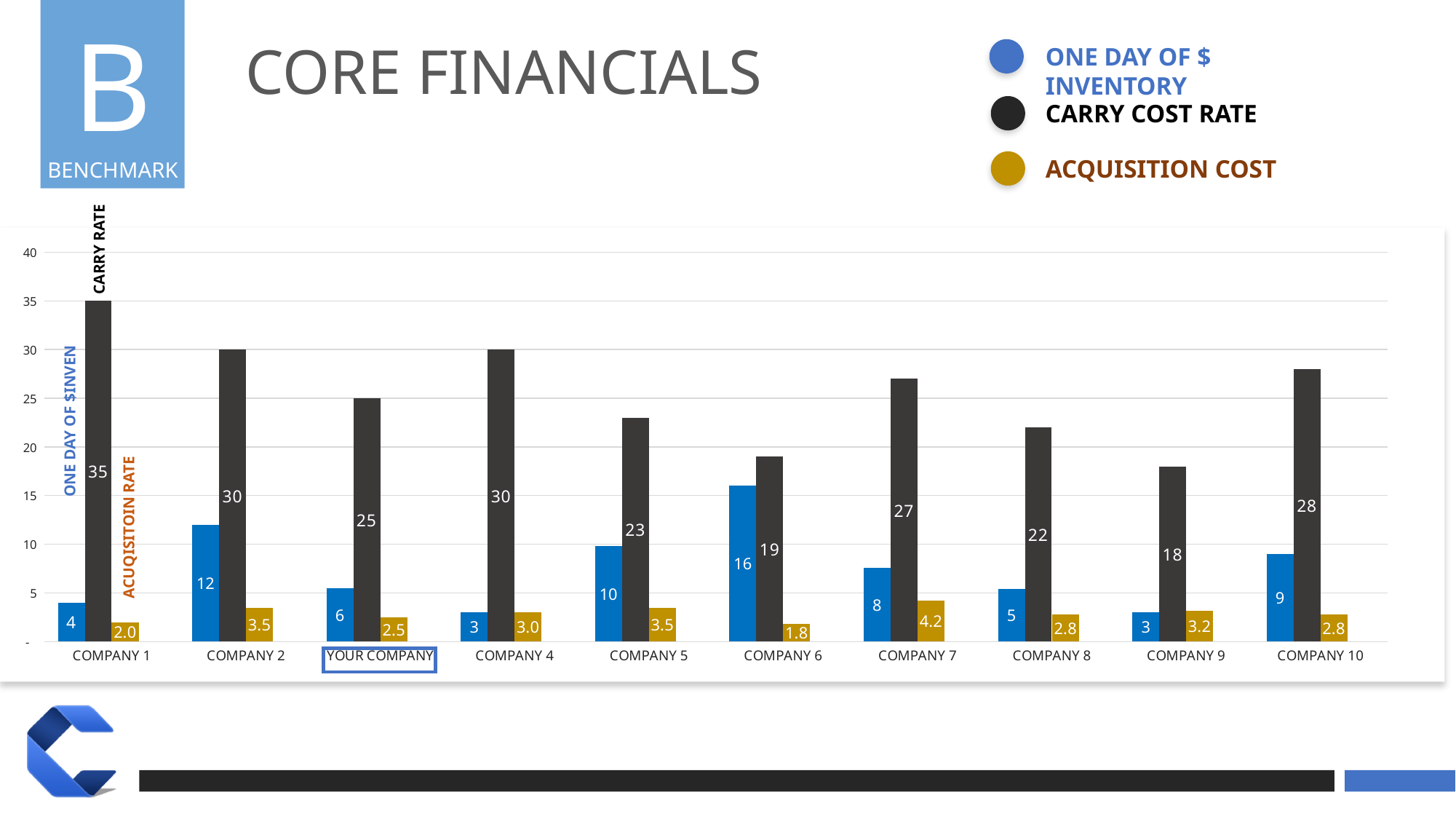
What is the difference between the Carry Cost Rate of Company 2 and Your Company? 5 How many series does the legend list? 3 What is the Carry Cost Rate value for Company 1? 35 Which company has the lowest Acquisition Cost? Company 6 Which is larger, the Carry Cost Rate for Company 7 or for Company 8? Company 7 Which company has the highest One Day of $ Inventory value? Company 6 How many companies are shown on the x axis of the chart? 10 What is the Acquisition Cost value for Company 7? 4.2 Which company has the highest Carry Cost Rate? Company 1 What type of chart is shown on the slide? Bar chart What is the One Day of $ Inventory value for Company 6? 16 What is the Carry Cost Rate value for Your Company? 25